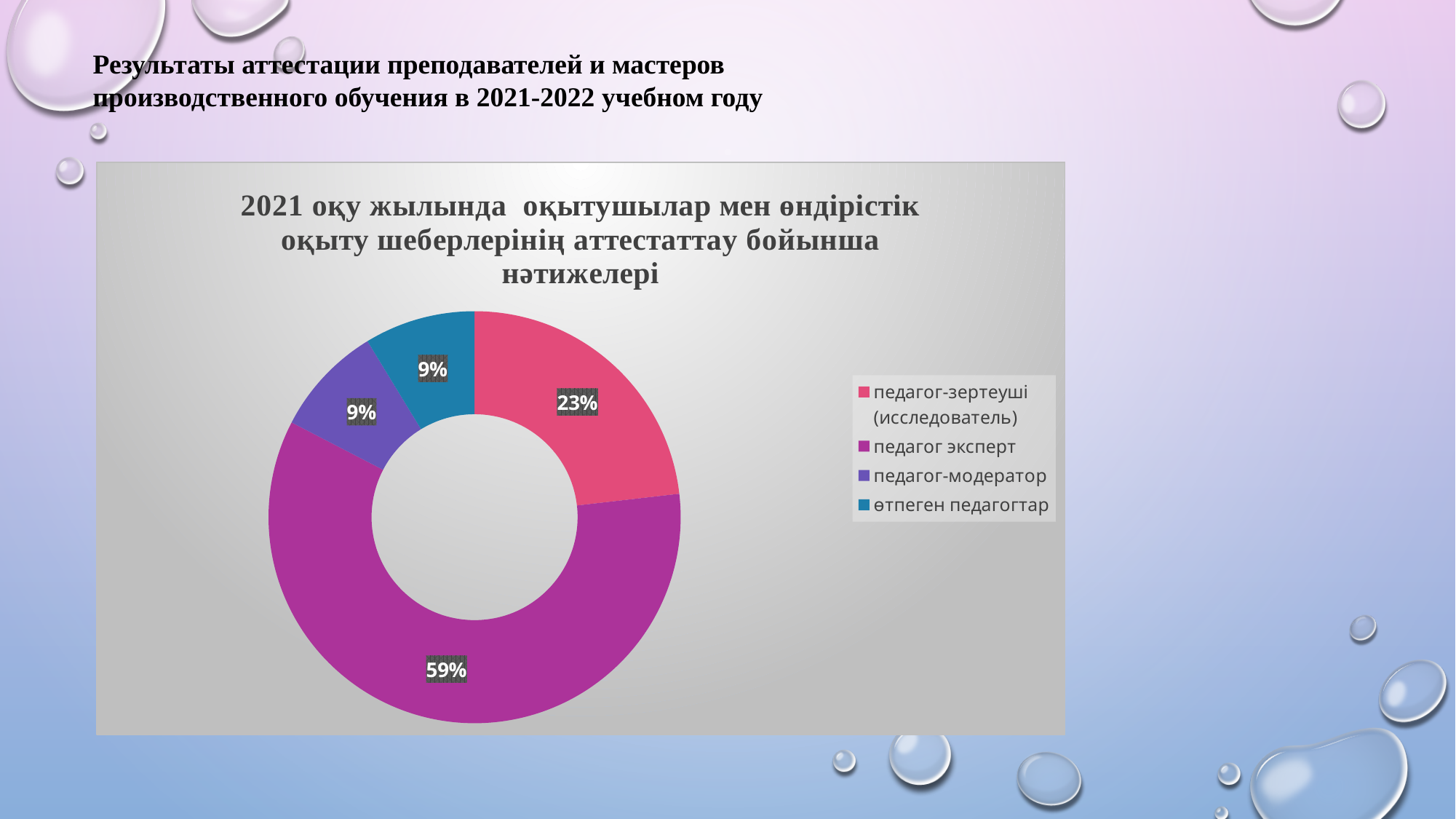
Which two categories have the same share of the chart? педагог-модератор and өтпеген педагогтар What percentage is shown for өтпеген педагогтар? 9% What kind of chart is shown on the slide? doughnut chart How many categories does the chart show? 4 How many entries does the legend list? 4 What percentage is shown for педагог эксперт? 59% Which category has the largest share of the chart? педагог эксперт What is the difference in percentage points between педагог эксперт and педагог-зертеуші (исследователь)? 36 What colour is the segment for өтпеген педагогтар? blue What percentage is shown for педагог-модератор? 9% Which is larger, the share for педагог эксперт or the share for педагог-зертеуші (исследователь)? педагог эксперт What percentage is shown for педагог-зертеуші (исследователь)? 23%